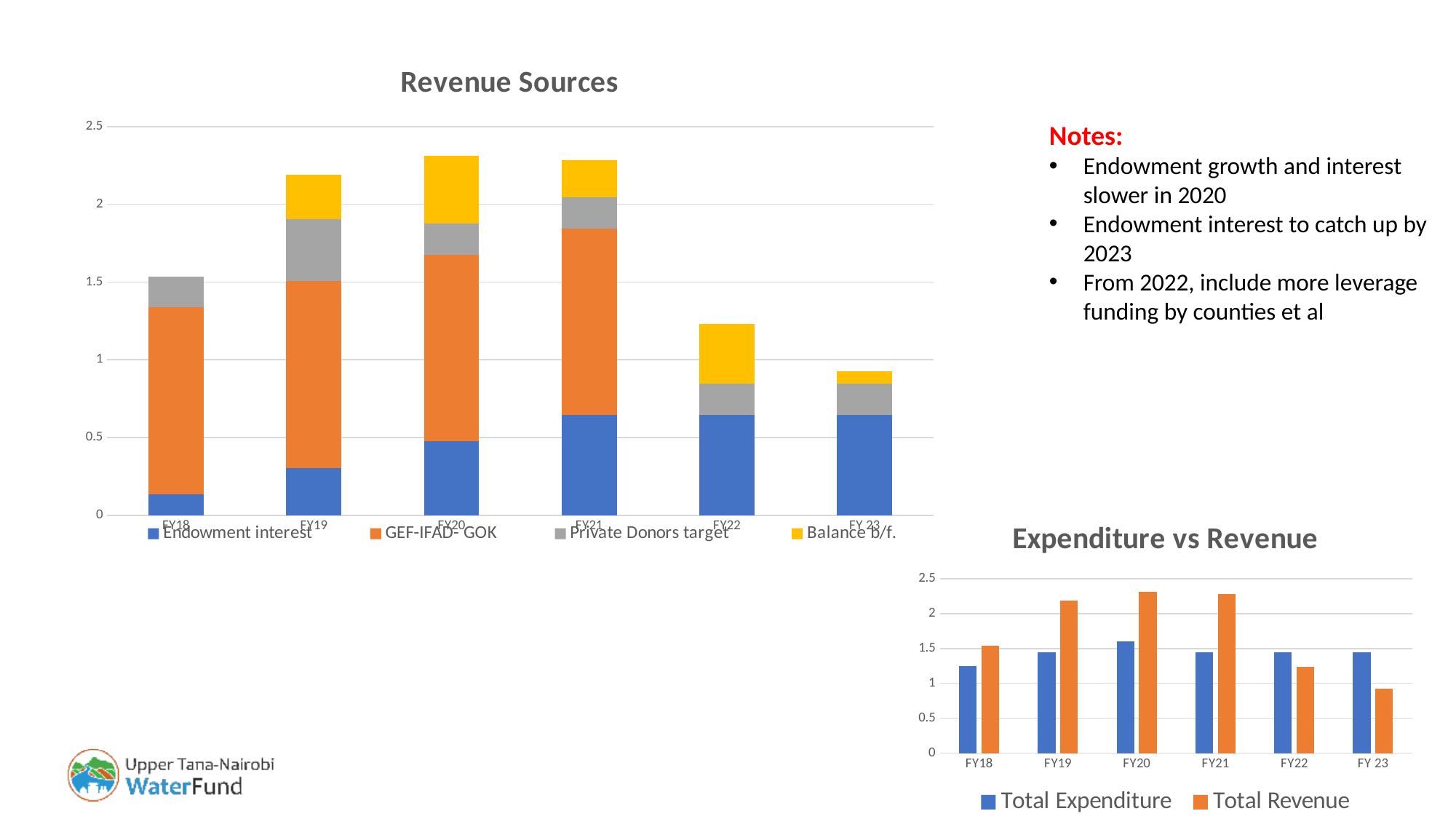
In the "Revenue Sources" chart, which series is shown in yellow? Balance b/f. In the "Expenditure vs Revenue" chart, which fiscal year has the lowest Total Revenue? FY 23 In the "Revenue Sources" chart, is the Endowment interest value for FY18 greater or less than 0.5? less In the "Expenditure vs Revenue" chart, which fiscal year has the highest Total Expenditure? FY20 How many series does the legend of the "Revenue Sources" chart list? 4 In the "Revenue Sources" chart, which fiscal year has the lowest total stacked bar? FY 23 How many fiscal years are shown on the x axis of the "Revenue Sources" chart? 6 In the "Expenditure vs Revenue" chart, does Total Revenue rise or fall from FY21 to FY 23? fall In the "Revenue Sources" chart, is the total stacked value for FY22 greater or less than 1? greater How many series does the legend of the "Expenditure vs Revenue" chart list? 2 What kind of chart is the "Revenue Sources" chart? stacked bar chart In the "Expenditure vs Revenue" chart, which is larger for FY22: Total Expenditure or Total Revenue? Total Expenditure